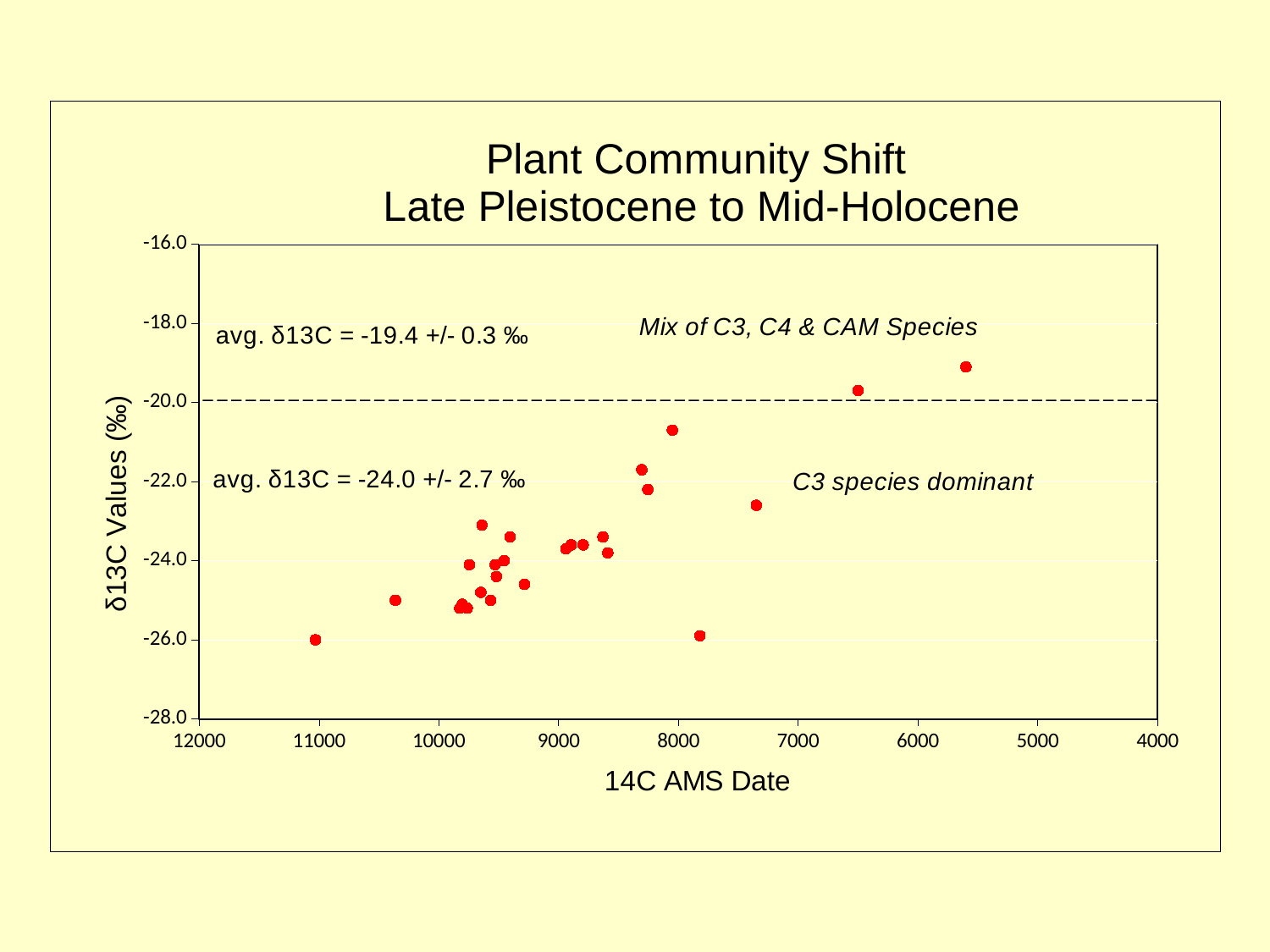
Which point has the higher δ13C value: the one near 6500 on the x axis or the one near 7350? the one near 6500 Is the δ13C value of the rightmost point (near 5600 on the x axis) greater or less than -20.0? greater Is the δ13C value of the point near 7800 on the x axis greater or less than -24.0? less What label is given to the x axis of the chart? 14C AMS Date Is the δ13C value of the leftmost point (near 11000 on the x axis) greater or less than -24.0? less What is the title of the chart? Plant Community Shift Late Pleistocene to Mid-Holocene Moving left to right along the x axis (from 12000 toward 4000), do the δ13C values generally rise or fall? rise Is the highest δ13C value found at the oldest (leftmost) or youngest (rightmost) 14C AMS date? youngest (rightmost) What kind of chart is shown on the slide? scatter chart What average δ13C value is printed for the upper group of points (Mix of C3, C4 & CAM Species)? -19.4 +/- 0.3 ‰ What average δ13C value is printed for the lower group of points (C3 species dominant)? -24.0 +/- 2.7 ‰